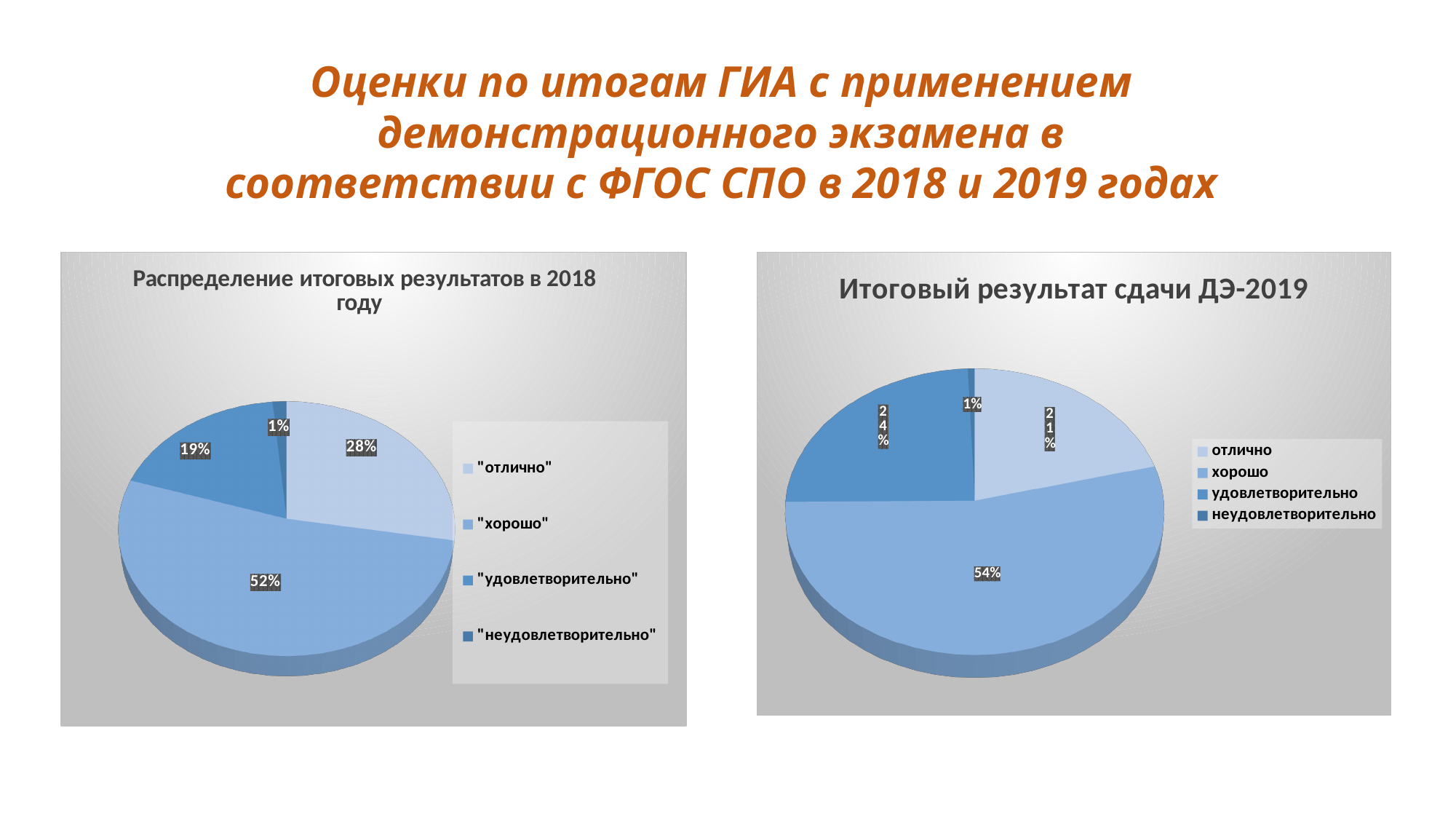
What type of chart is the right chart (Итоговый результат сдачи ДЭ-2019)? Pie chart In the right chart (Итоговый результат сдачи ДЭ-2019), what share is labelled for хорошо? 54% In the left chart (Распределение итоговых результатов в 2018 году), what share is labelled for "удовлетворительно"? 19% In the left chart (Распределение итоговых результатов в 2018 году), what share is labelled for "хорошо"? 52% In the left chart (Распределение итоговых результатов в 2018 году), what is the difference between the shares for "хорошо" and "отлично"? 24% In the left chart (Распределение итоговых результатов в 2018 году), which category has the smallest slice? "неудовлетворительно" How many categories does the legend of the left chart (Распределение итоговых результатов в 2018 году) list? 4 In the right chart (Итоговый результат сдачи ДЭ-2019), which is larger, the share for отлично or the share for удовлетворительно? удовлетворительно In the right chart (Итоговый результат сдачи ДЭ-2019), what share is labelled for удовлетворительно? 24% In the left chart (Распределение итоговых результатов в 2018 году), what share is labelled for "отлично"? 28% In the right chart (Итоговый результат сдачи ДЭ-2019), which category has the largest slice? хорошо In the right chart (Итоговый результат сдачи ДЭ-2019), what share is labelled for отлично? 21%